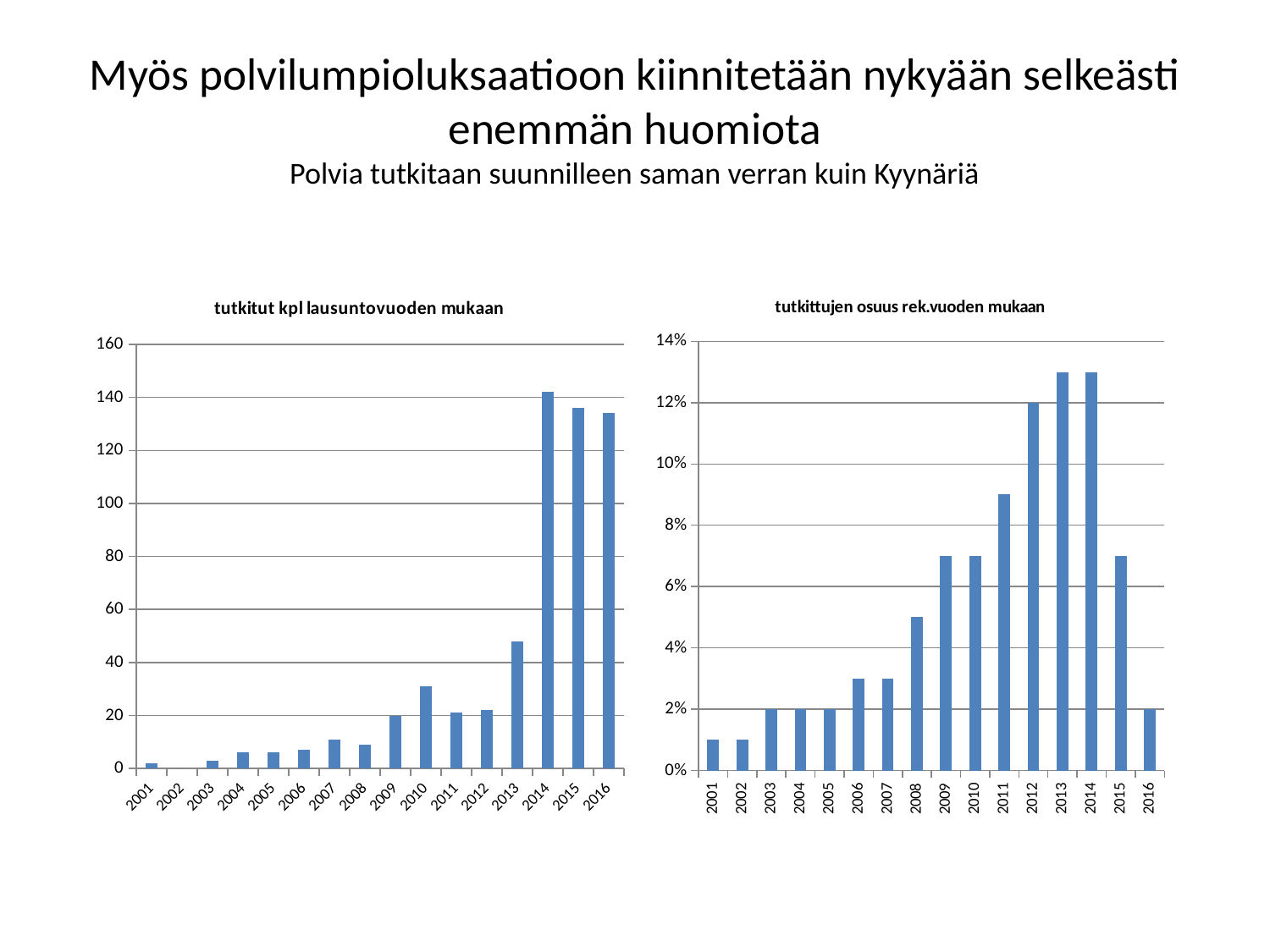
In the left chart "tutkitut kpl lausuntovuoden mukaan", is the value for 2013 greater or less than 40? greater In the left chart "tutkitut kpl lausuntovuoden mukaan", which is larger, the value for 2010 or the value for 2011? 2010 What kind of chart is the left chart titled "tutkitut kpl lausuntovuoden mukaan"? bar chart How many years are shown on the x axis of the left chart "tutkitut kpl lausuntovuoden mukaan"? 16 In the left chart "tutkitut kpl lausuntovuoden mukaan", is the value for 2016 greater or less than 120? greater In the right chart "tutkittujen osuus rek.vuoden mukaan", is the value for 2011 greater or less than 8%? greater In the right chart "tutkittujen osuus rek.vuoden mukaan", what is the value for 2016? 2% In the right chart "tutkittujen osuus rek.vuoden mukaan", which is larger, the value for 2008 or the value for 2015? 2015 In the left chart "tutkitut kpl lausuntovuoden mukaan", do the values generally rise or fall from 2001 to 2016? rise In the left chart "tutkitut kpl lausuntovuoden mukaan", which year has the highest bar? 2014 In the right chart "tutkittujen osuus rek.vuoden mukaan", what is the value for 2012? 12%